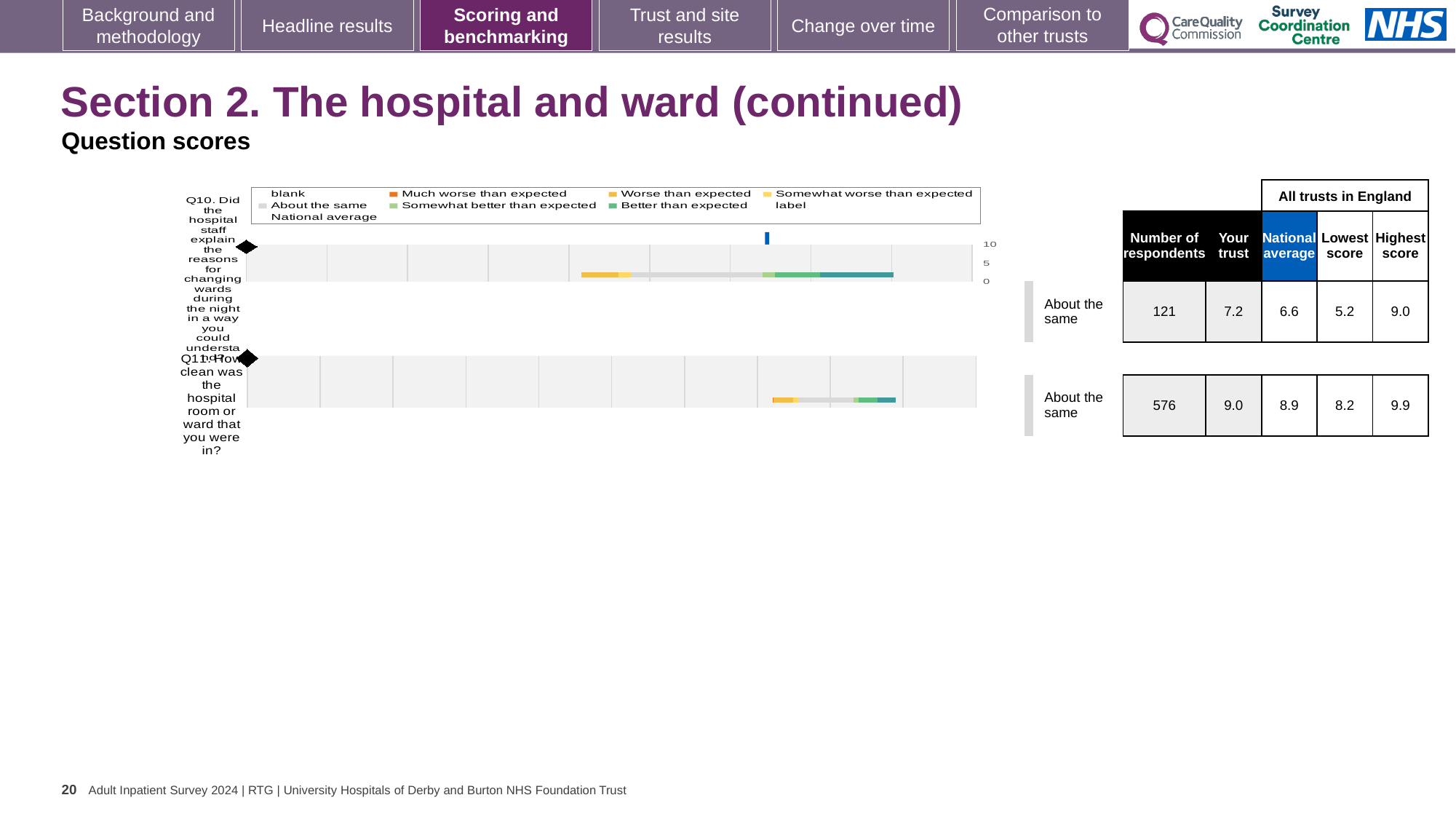
For Q10, is the trust's score higher or lower than the national average? Higher Which question has the higher 'Your trust' score, Q10 or Q11? Q11 What is the difference between the highest and lowest scores for Q10? 3.8 What kind of chart is used to show the question scores? Bar chart What benchmark category is shown for both Q10 and Q11? About the same What is the difference between the trust's score and the national average for Q11? 0.1 How many respondents answered Q10? 121 What is the lowest score among all trusts in England for Q10? 5.2 What is the highest score among all trusts in England for Q11? 9.9 How many survey questions are charted on this slide? 2 What is the national average score for Q11 (how clean was the hospital room or ward)? 8.9 What is the 'Your trust' score for Q10 (explaining reasons for changing wards during the night)? 7.2